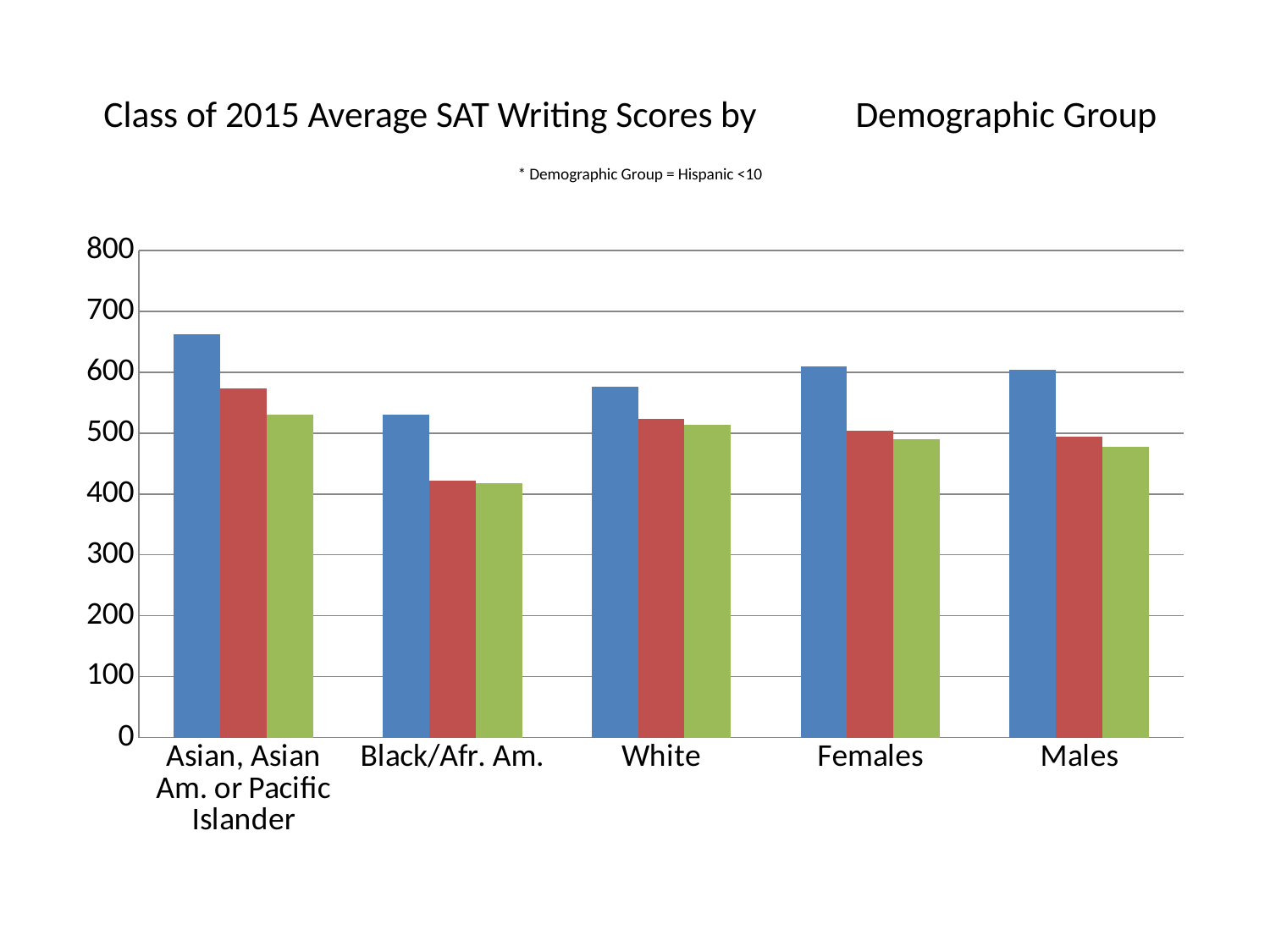
Is the blue bar for White greater or less than 600? less Which is larger, the blue bar for Asian, Asian Am. or Pacific Islander or the blue bar for White? Asian, Asian Am. or Pacific Islander What is the title of the chart? Class of 2015 Average SAT Writing Scores by Demographic Group Which demographic group has the tallest blue bar? Asian, Asian Am. or Pacific Islander Which is larger, the red bar for White or the red bar for Black/Afr. Am.? White Which demographic group has the shortest blue bar? Black/Afr. Am. How many bars are plotted for each demographic group? 3 What kind of chart is shown on the slide? bar chart How many demographic groups are shown on the x axis? 5 Is the red bar for Black/Afr. Am. greater or less than 500? less Is the green bar for Males greater or less than 500? less